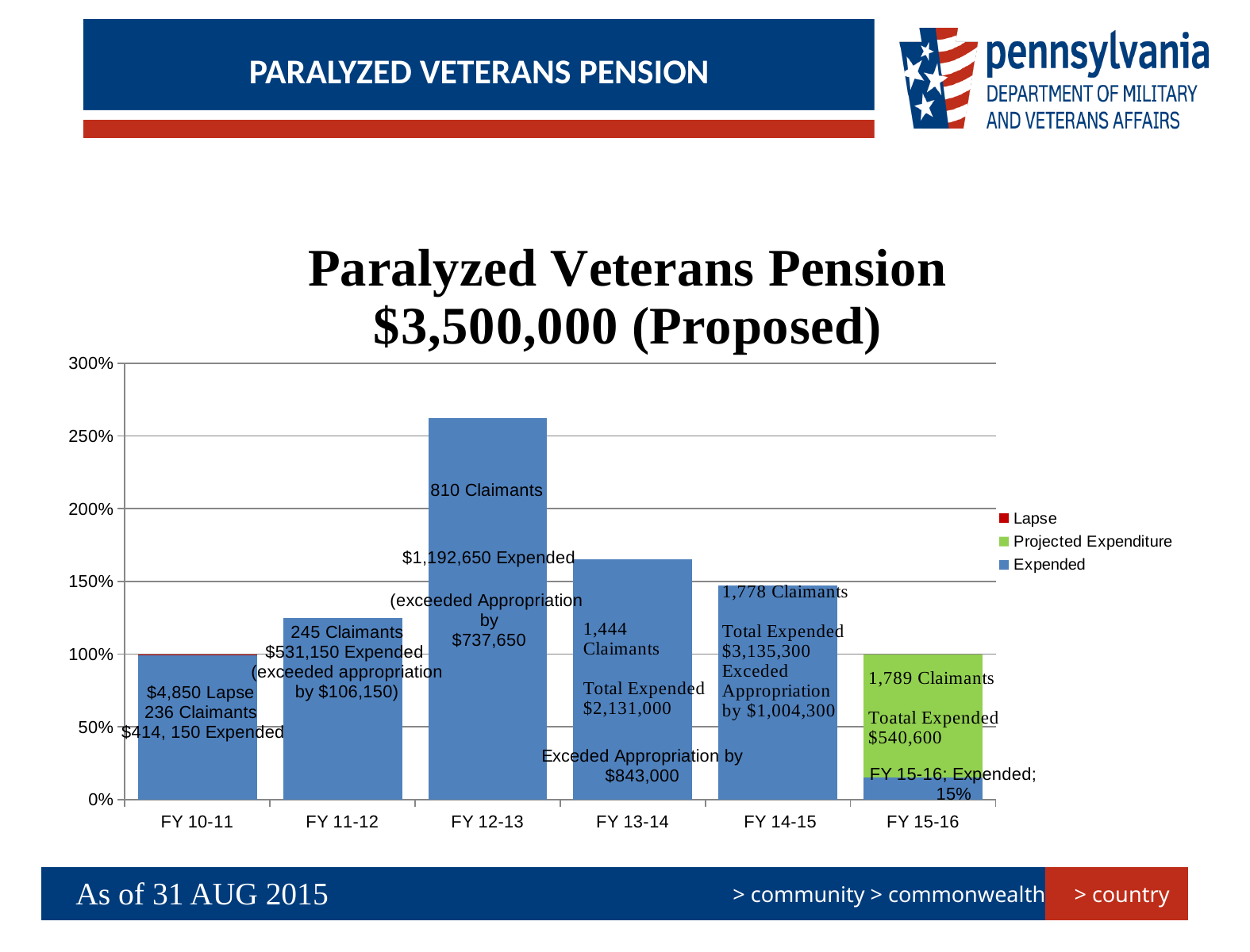
Is the bar for FY 13-14 greater or less than 150%? greater Which fiscal year has the tallest bar in the chart? FY 12-13 Which bar is taller, FY 13-14 or FY 14-15? FY 13-14 Is the bar for FY 12-13 greater or less than 250%? greater How many fiscal years are shown on the x axis of the chart? 6 What kind of chart is shown on the slide? Bar chart How many claimants are shown for FY 12-13? 810 Claimants Is the bar for FY 11-12 greater or less than 150%? less Which legend series does the green bar for FY 15-16 belong to? Projected Expenditure What is the total expended shown for FY 14-15? $3,135,300 How many series does the chart's legend list? 3 What lapse amount is shown for FY 10-11? $4,850